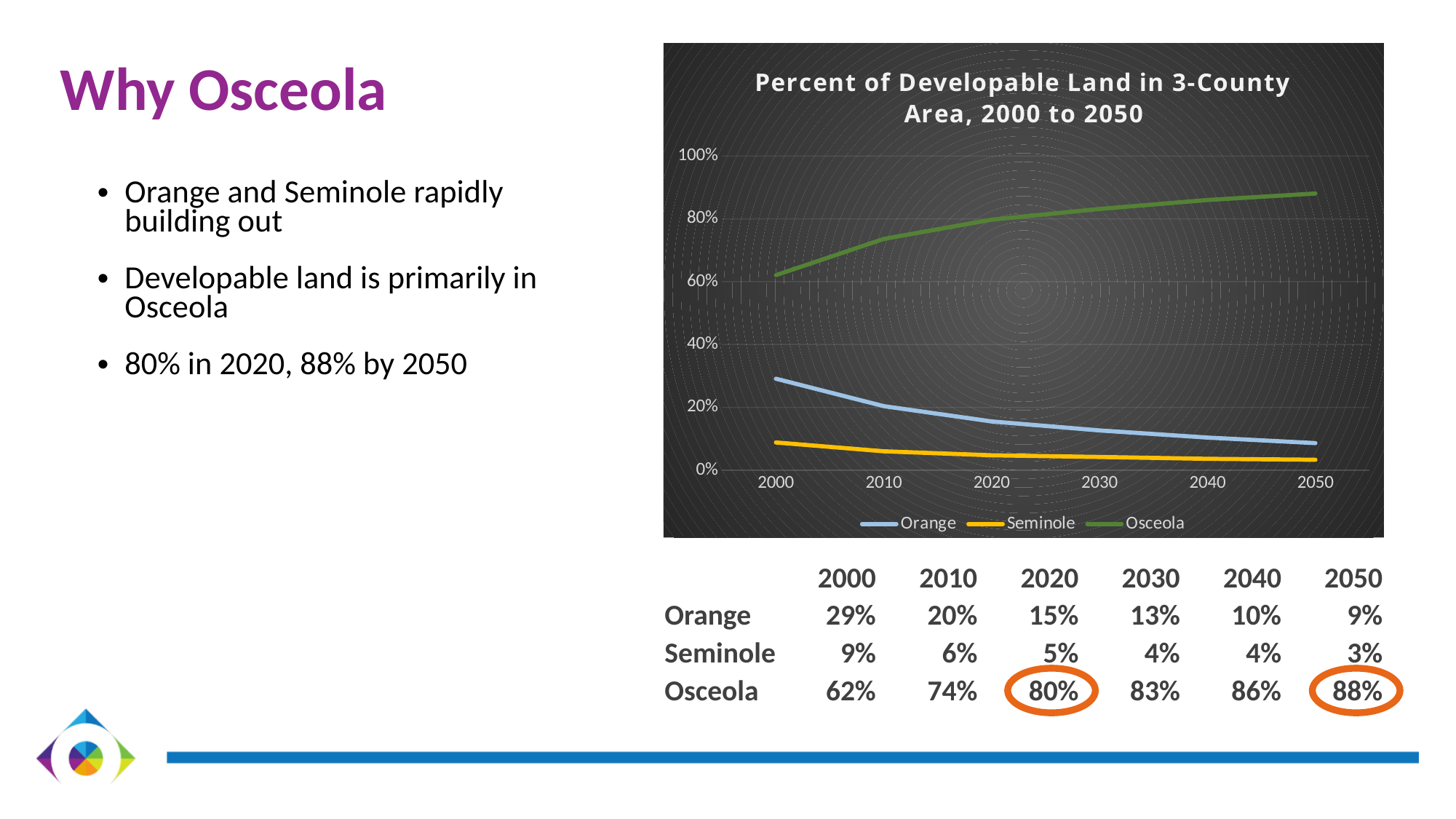
What is the value for Seminole in 2050? 3% Which is larger in 2010, the value for Orange or the value for Seminole? Orange Which county has the lowest value in 2000? Seminole What is the difference between Osceola's value in 2050 and its value in 2000? 26% What is the title of the chart? Percent of Developable Land in 3-County Area, 2000 to 2050 What is the value for Orange in 2000? 29% Does the Orange line rise or fall from 2000 to 2050? fall How many series does the chart's legend list? 3 Which county has the highest value in 2050? Osceola How many years are plotted along the x axis of the chart? 6 What is the value for Osceola in 2020? 80% What kind of chart is shown on the slide? line chart